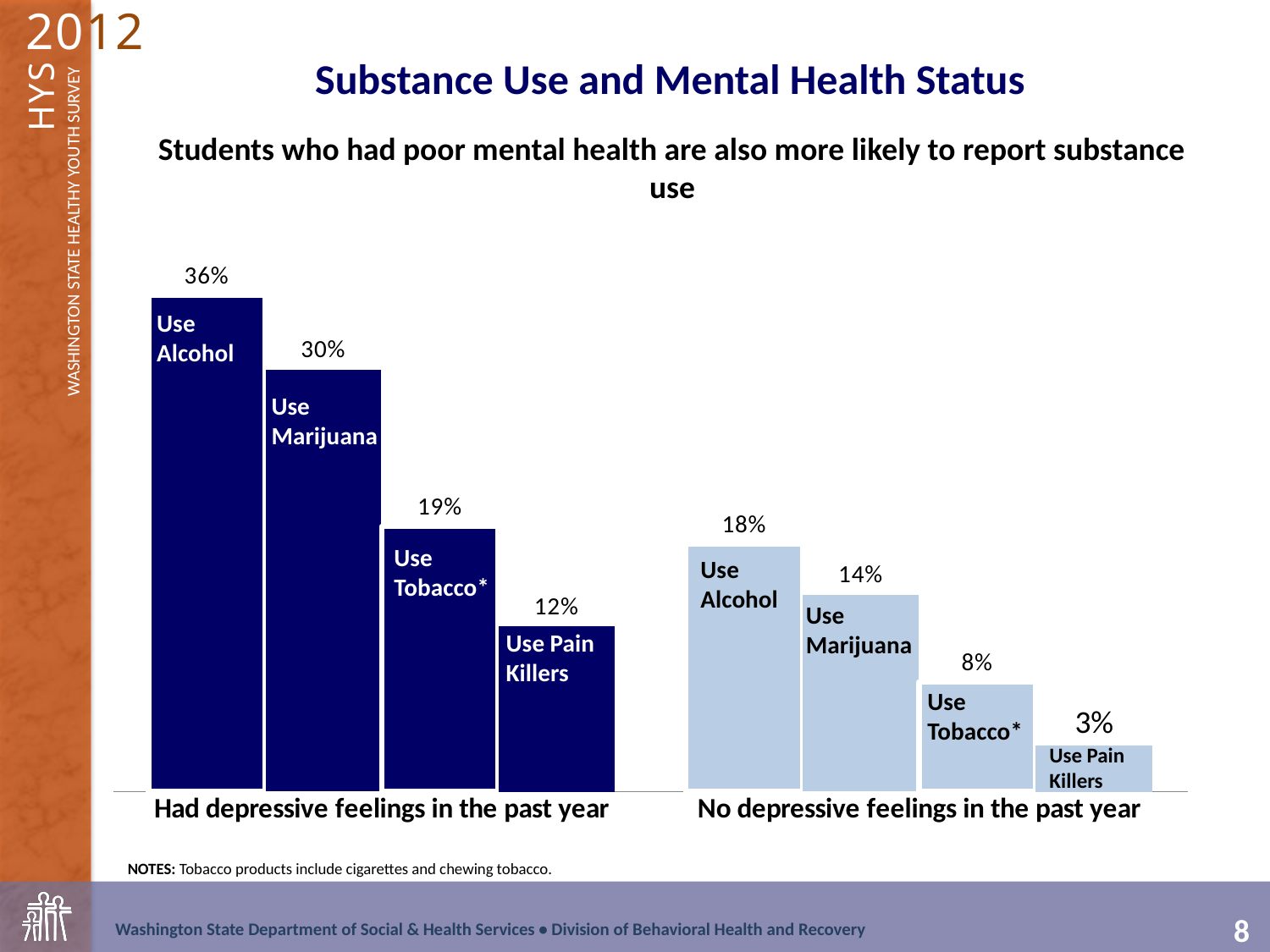
What is the title of the chart? Substance Use and Mental Health Status Within each group, do the values rise or fall from left to right? Fall What is the difference in alcohol use between students who had depressive feelings and those with no depressive feelings? 18% What is the difference between tobacco use and pain killer use among students who had depressive feelings in the past year? 7% Which substance has the lowest reported use among students with no depressive feelings in the past year? Use Pain Killers Which is larger: marijuana use among students who had depressive feelings, or alcohol use among students with no depressive feelings? Marijuana use among students who had depressive feelings What percentage of students who had depressive feelings in the past year reported using alcohol? 36% Which substance has the highest reported use among students who had depressive feelings in the past year? Use Alcohol What kind of chart is shown on the slide? Bar chart How many substance categories are shown for each group? 4 What percentage of students with no depressive feelings in the past year reported using marijuana? 14% What percentage of students with no depressive feelings in the past year reported using pain killers? 3%